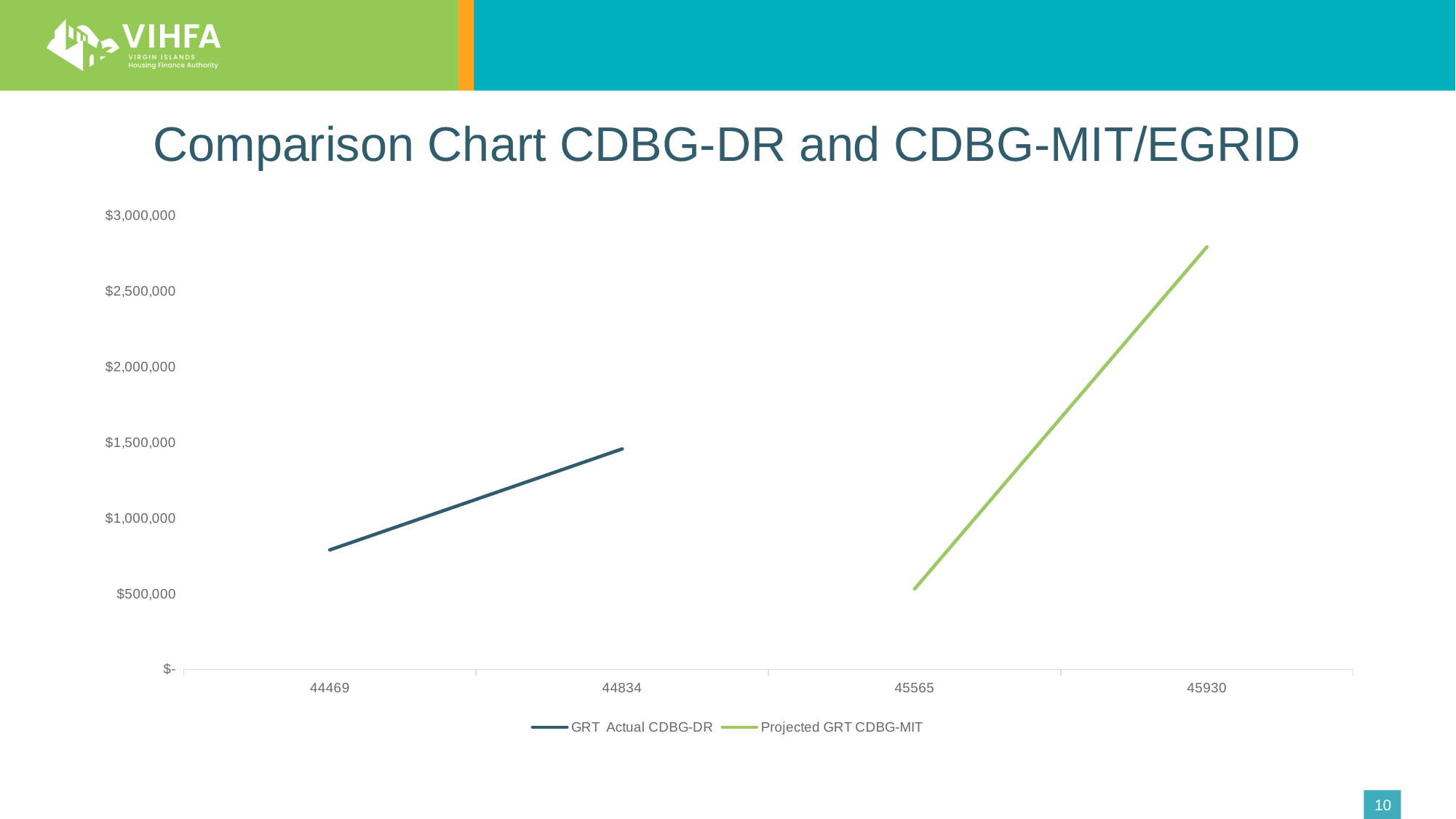
Which is larger: Projected GRT CDBG-MIT at 45930 or GRT Actual CDBG-DR at 44834? Projected GRT CDBG-MIT at 45930 How many series does the legend list? 2 Does the Projected GRT CDBG-MIT line rise or fall from 45565 to 45930? rise Does the GRT Actual CDBG-DR line rise or fall from 44469 to 44834? rise Which series is drawn in green? Projected GRT CDBG-MIT Is the value for Projected GRT CDBG-MIT at 45930 greater or less than $2,500,000? greater Is the value for Projected GRT CDBG-MIT at 45565 greater or less than $1,000,000? less Is the value for GRT Actual CDBG-DR at 44834 greater or less than $1,000,000? greater What kind of chart is shown on the slide? line chart What is the title of the chart? Comparison Chart CDBG-DR and CDBG-MIT/EGRID How many categories are shown on the x axis? 4